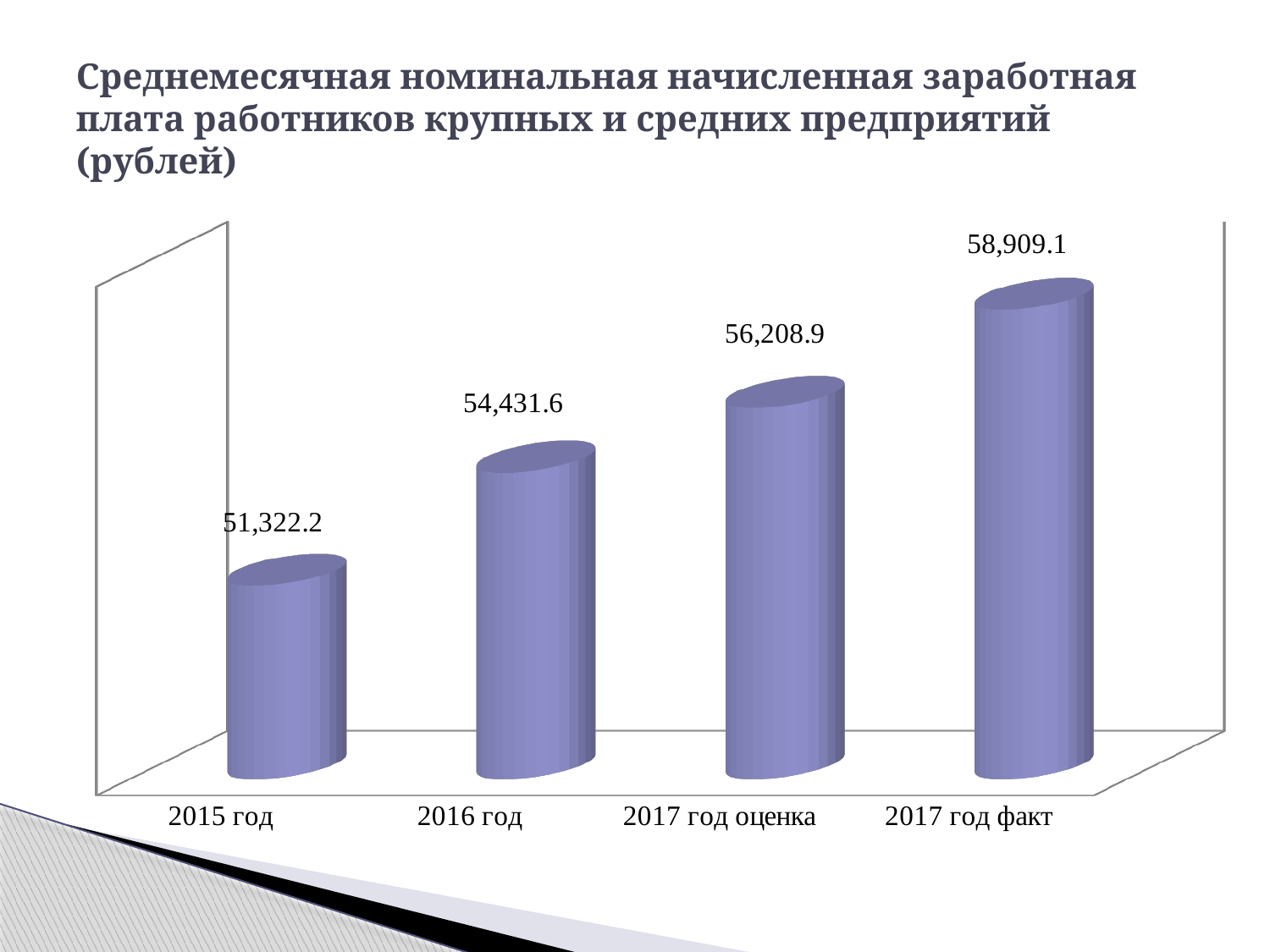
What is the value for 2015 год? 51,322.2 What kind of chart is shown on the slide? Bar chart What is the difference between the values for 2017 год факт and 2015 год? 7,586.9 Which is larger, the value for 2016 год or the value for 2017 год оценка? 2017 год оценка What is the value for 2017 год факт? 58,909.1 What is the difference between the values for 2017 год факт and 2017 год оценка? 2,700.2 Which category has the lowest value? 2015 год Do the values rise or fall from left to right along the x axis? Rise What is the value for 2016 год? 54,431.6 What is the value for 2017 год оценка? 56,208.9 Which category has the highest value? 2017 год факт How many categories are shown on the chart? 4